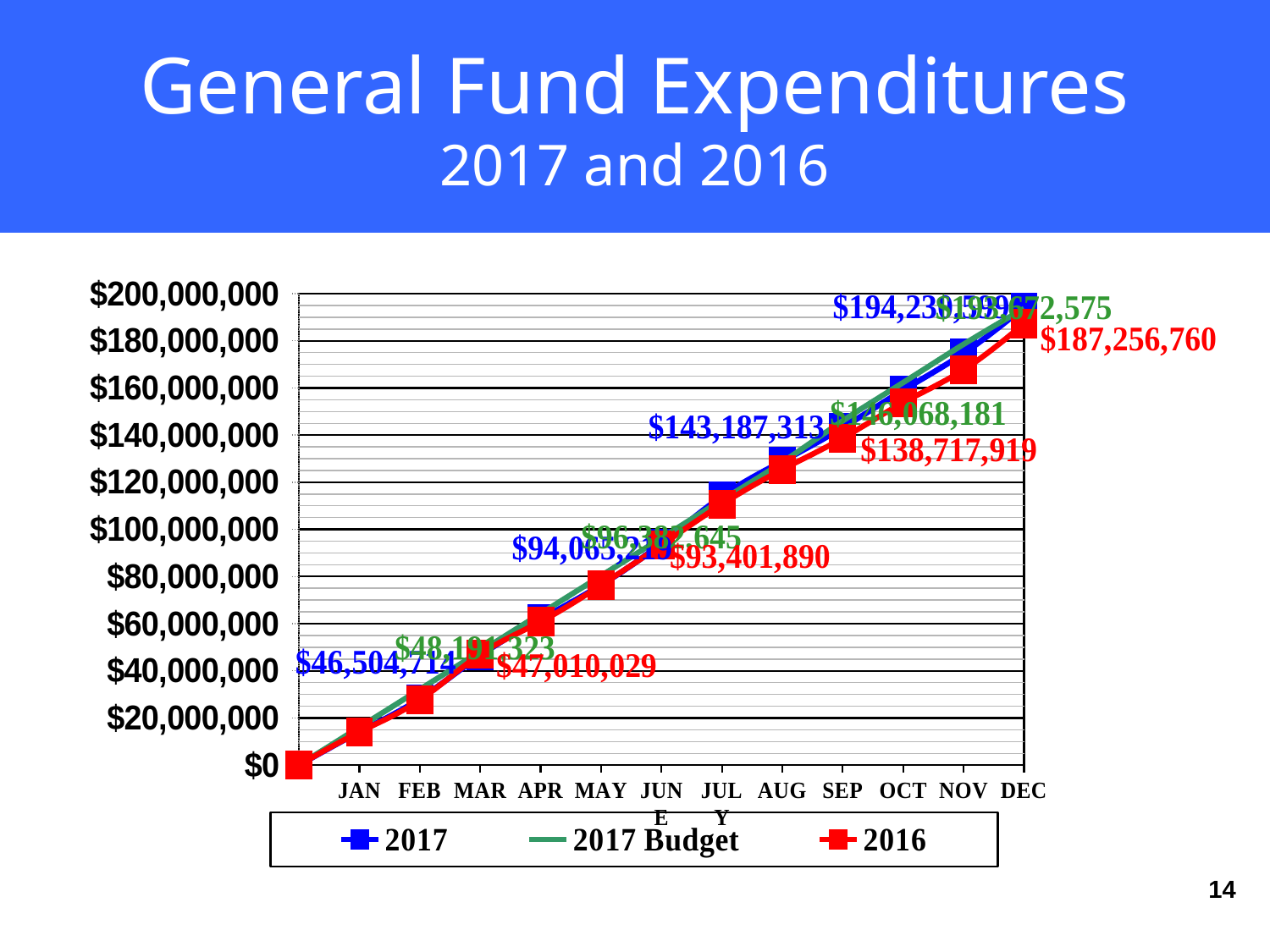
What is the 2017 value for MAR? $46,504,714 Is the 2016 value for DEC greater or less than $180,000,000? greater What is the 2016 value for DEC? $187,256,760 What kind of chart is shown on the slide? Line chart What is the 2017 value for SEP? $143,187,313 What is the 2016 value for JUN? $93,401,890 How many series does the legend list? 3 What is the difference between the 2017 and 2016 values for SEP? $4,469,394 What is the 2016 value for MAR? $47,010,029 In MAR, which is larger: the 2017 value or the 2017 Budget value? 2017 Budget Do the values rise or fall from JAN to DEC? Rise What is the 2017 Budget value for MAR? $48,191,323